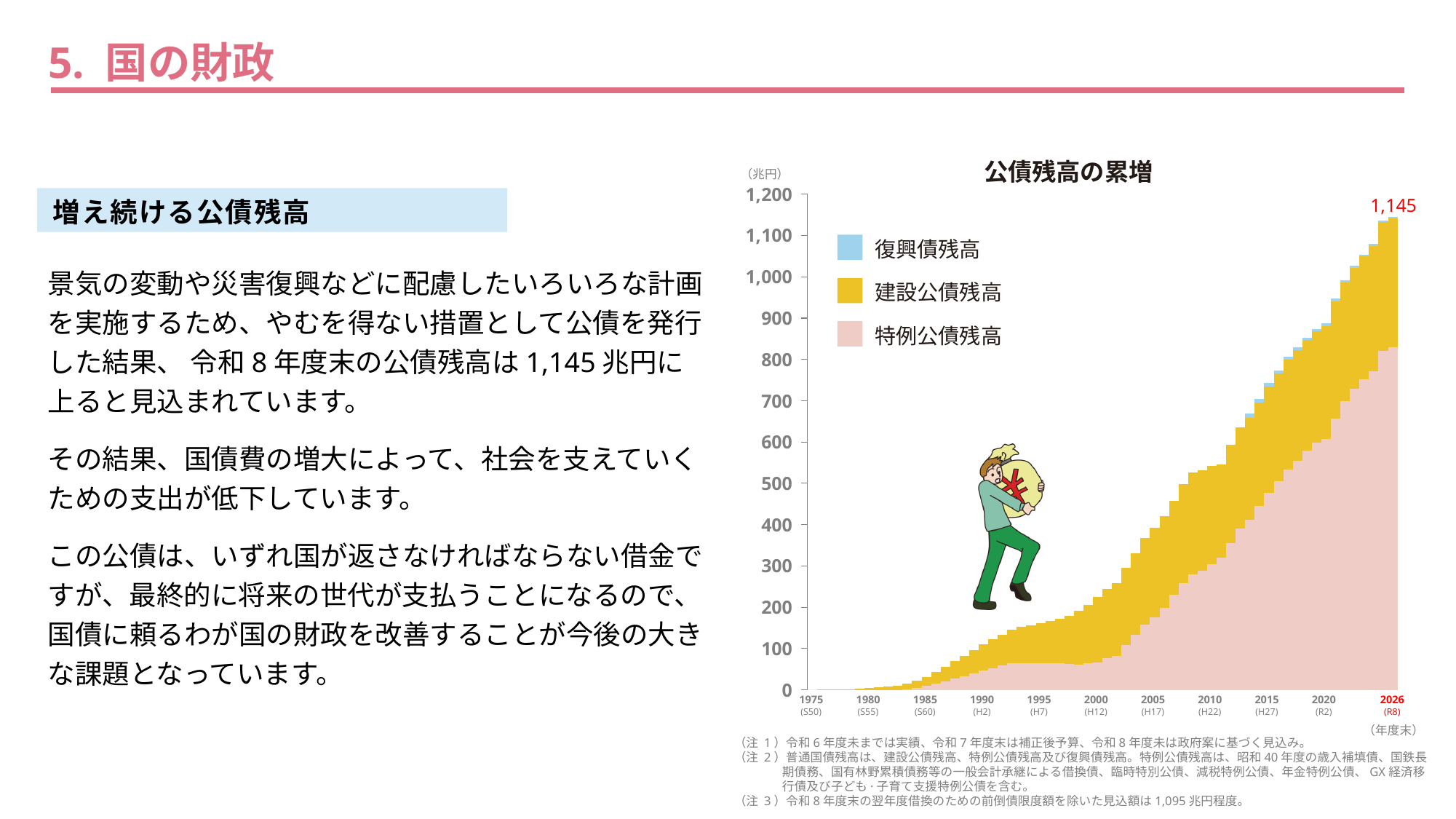
What kind of chart is shown on the slide? stacked bar chart What is the total public debt outstanding shown for 2026 (R8)? 1,145 Is the total value for 1980 (S55) greater or less than 100? less Is the total value for 2010 (H22) greater or less than 500? greater Which year has the highest total public debt outstanding? 2026 (R8) Is the total value for 2020 (R2) greater or less than 800? greater In 2026 (R8), which series accounts for the larger portion of the bar, 建設公債残高 or 特例公債残高? 特例公債残高 Which is larger, the total for 2015 (H27) or the total for 2005 (H17)? 2015 (H27) How many series does the chart's legend list? 3 Which colour represents 特例公債残高 in the legend? pink Do the values rise or fall from 1975 to 2026 along the x axis? rise What is the title of the chart? 公債残高の累増